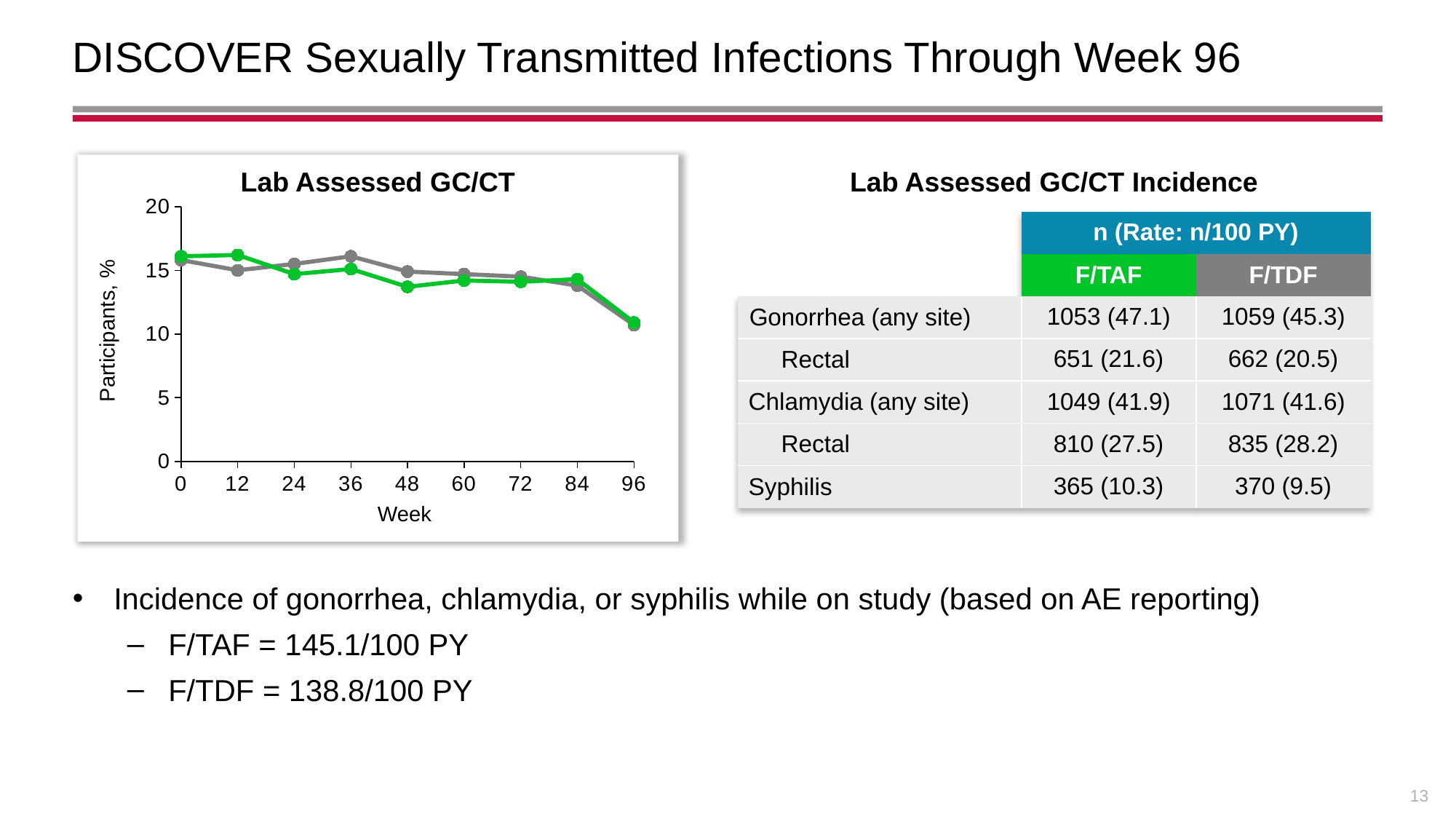
How many lines are plotted in the "Lab Assessed GC/CT" chart? 2 In the "Lab Assessed GC/CT" chart, is the green line's value at week 12 greater or less than 15? greater In the "Lab Assessed GC/CT" chart, at which week is the green line at its lowest value? 96 What kind of chart is the "Lab Assessed GC/CT" chart? line chart In the "Lab Assessed GC/CT" chart, at which week is the gray line at its lowest value? 96 In the "Lab Assessed GC/CT" chart, do the values generally rise or fall from week 0 to week 96? fall What is the y-axis label of the "Lab Assessed GC/CT" chart? Participants, % In the "Lab Assessed GC/CT" chart, is the green line's value at week 96 greater or less than 15? less In the "Lab Assessed GC/CT" chart, is the green line's value at week 48 greater or less than 15? less In the "Lab Assessed GC/CT" chart, which line has the higher value at week 12, the green line or the gray line? green line How many time points (weeks) are plotted along the x axis of the "Lab Assessed GC/CT" chart? 9 In the "Lab Assessed GC/CT" chart, which line has the higher value at week 48, the green line or the gray line? gray line